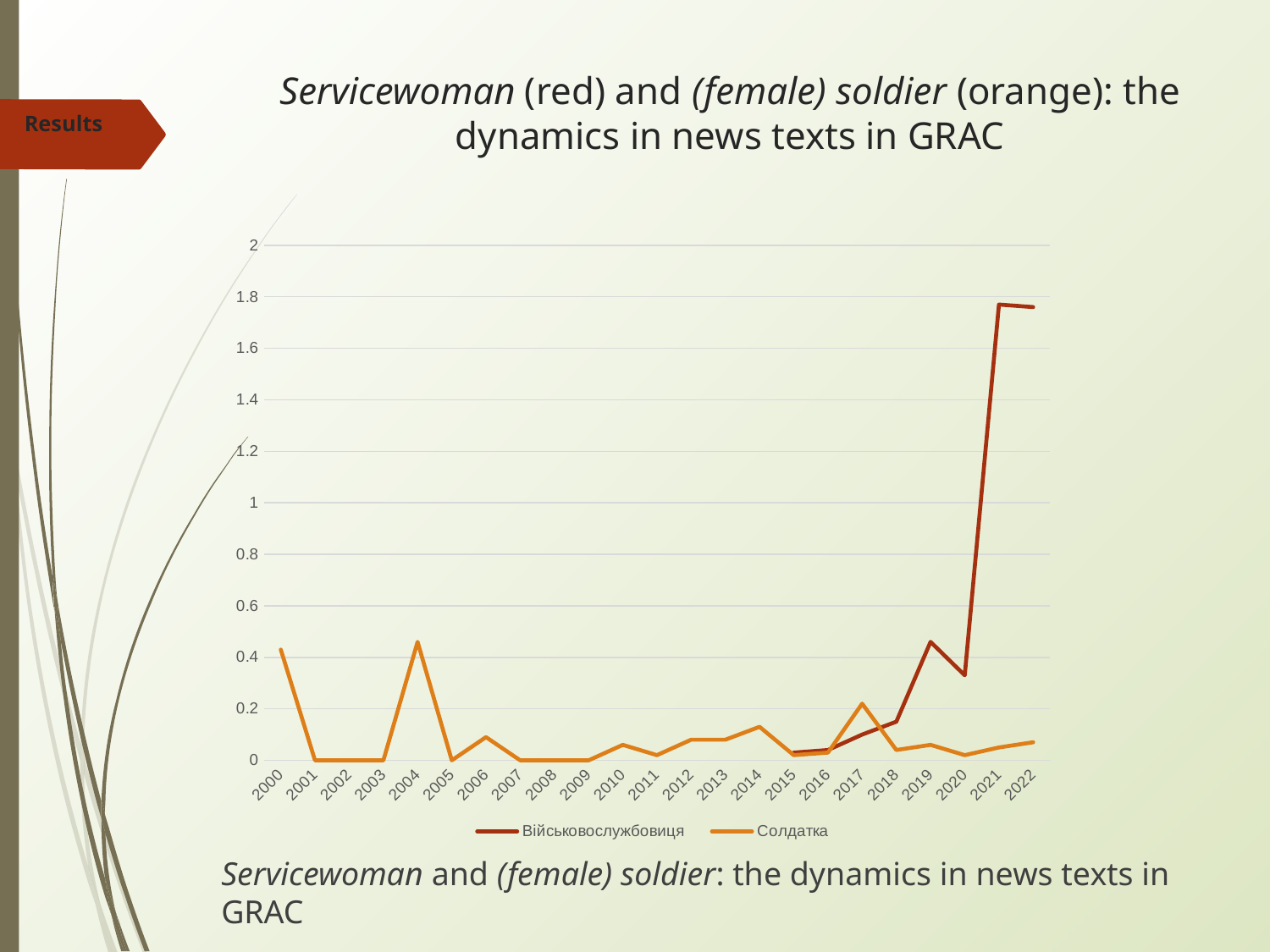
How many series does the legend list? 2 What is the value for Солдатка in 2001? 0 How many years are shown along the x axis? 23 What kind of chart is shown on the slide? line chart Is the value for Військовослужбовиця in 2020 greater or less than 0.4? less Is the value for Військовослужбовиця in 2019 greater or less than 0.4? greater Is the value for Солдатка in 2004 greater or less than 0.4? greater In 2019, which series has the higher value, Військовослужбовиця or Солдатка? Військовослужбовиця In 2017, which series has the higher value, Військовослужбовиця or Солдатка? Солдатка What colour is the Солдатка line in the chart? orange Does the Військовослужбовиця line rise or fall from 2018 to 2021? rise